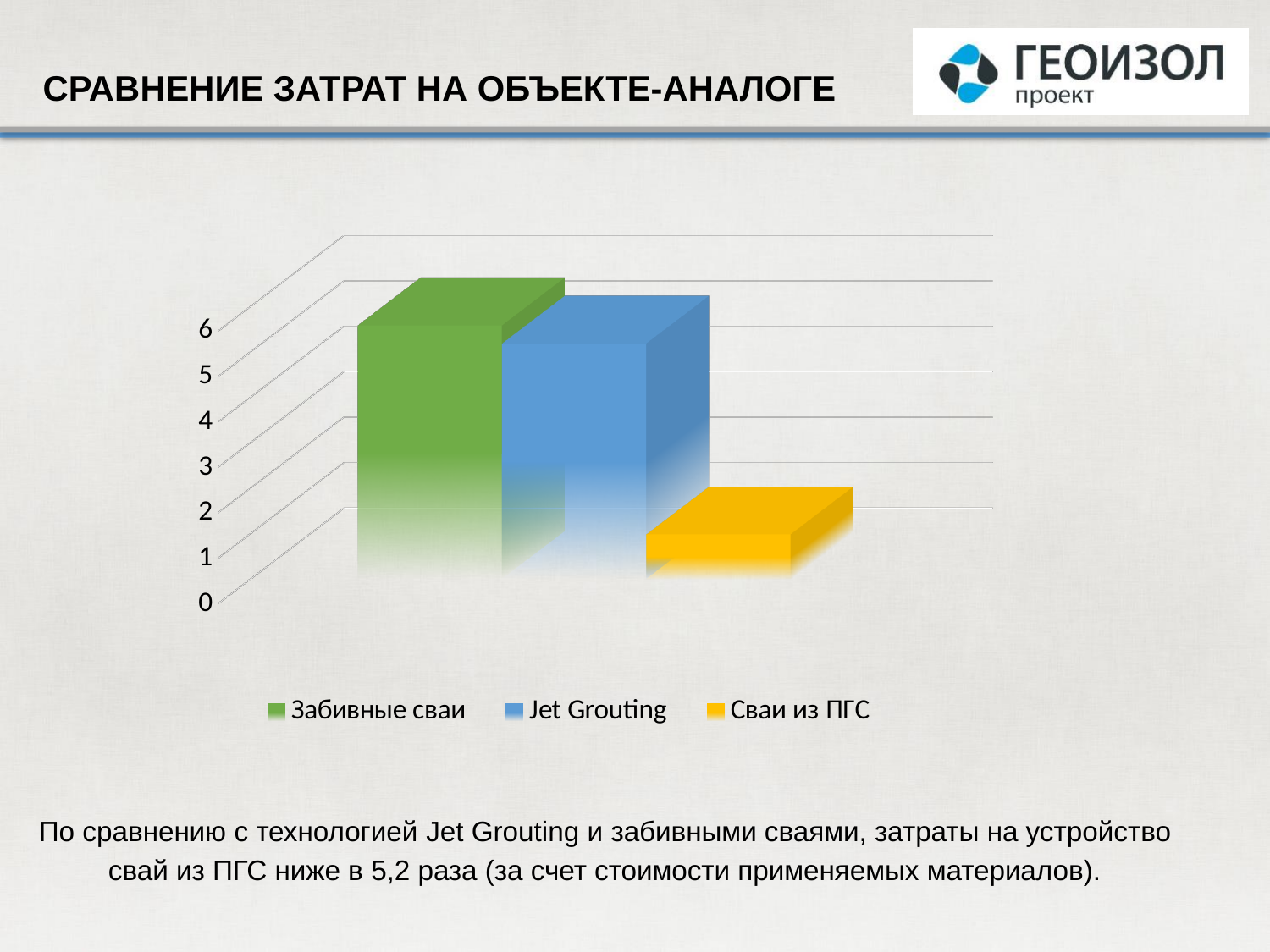
Which is larger, the value for Jet Grouting or the value for Сваи из ПГС? Jet Grouting What colour is the bar for Сваи из ПГС? yellow Which is larger, the value for Забивные сваи or the value for Сваи из ПГС? Забивные сваи Is the value for Jet Grouting greater or less than 3? greater How many series does the legend list? 3 What is the highest value shown on the vertical axis? 6 Is the value for Забивные сваи greater or less than 4? greater Is the value for Сваи из ПГС greater or less than 2? less Which series has the lowest bar? Сваи из ПГС What kind of chart is shown on the slide? bar chart Which series has the highest bar? Забивные сваи